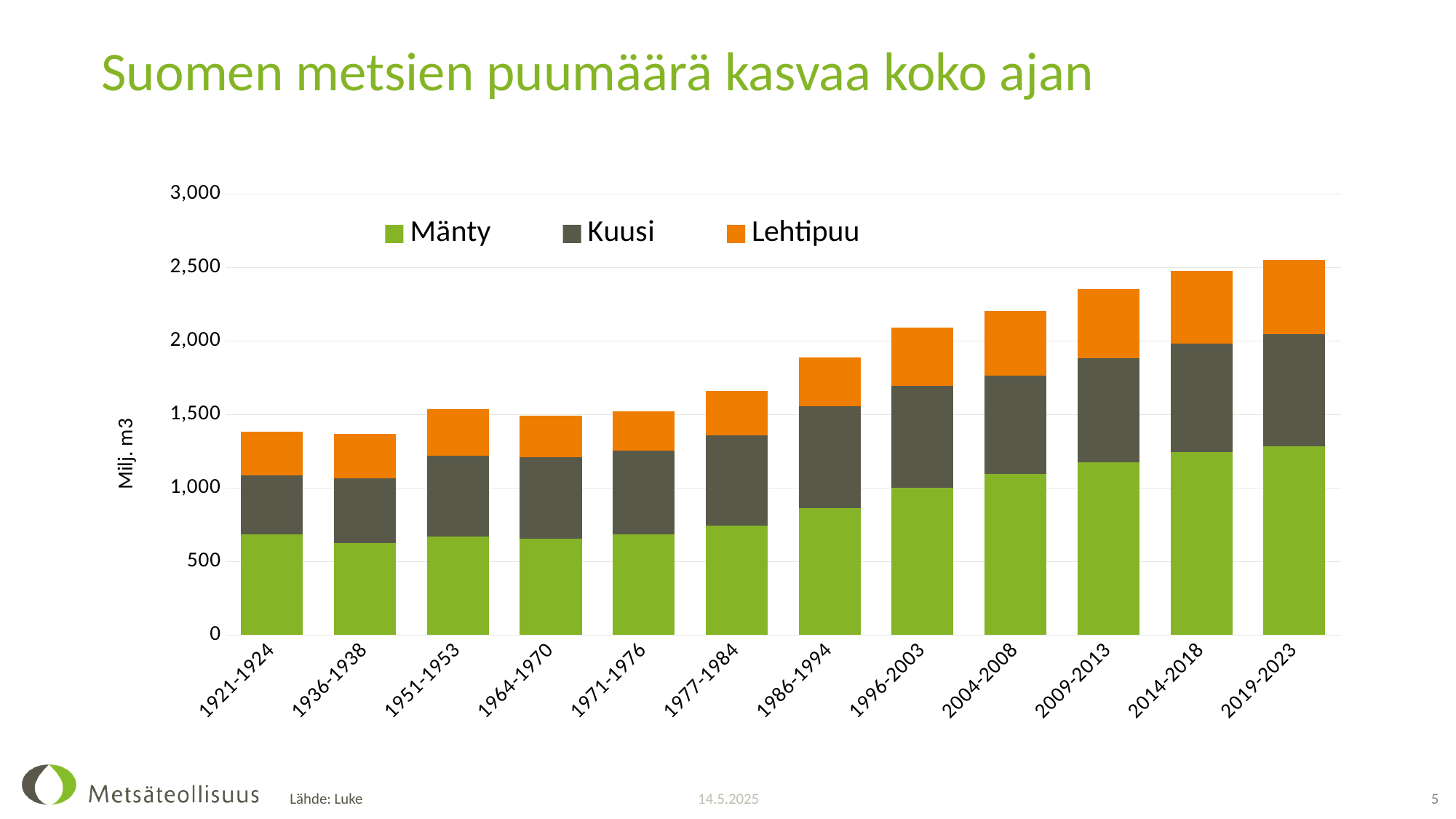
Which period has the highest total stacked bar? 2019-2023 Which series is shown in orange? Lehtipuu What kind of chart is shown on the slide? Stacked bar chart How many series does the legend list? 3 What is the label on the y axis? Milj. m3 Is the total for 2019-2023 greater or less than 2,500? greater How many time periods are shown on the x axis? 12 Which has the larger total, 2014-2018 or 1996-2003? 2014-2018 Is the total for 1986-1994 greater or less than 2,000? less Is the total for 1921-1924 greater or less than 1,500? less Do the total bar heights generally rise or fall from 1921-1924 to 2019-2023? rise